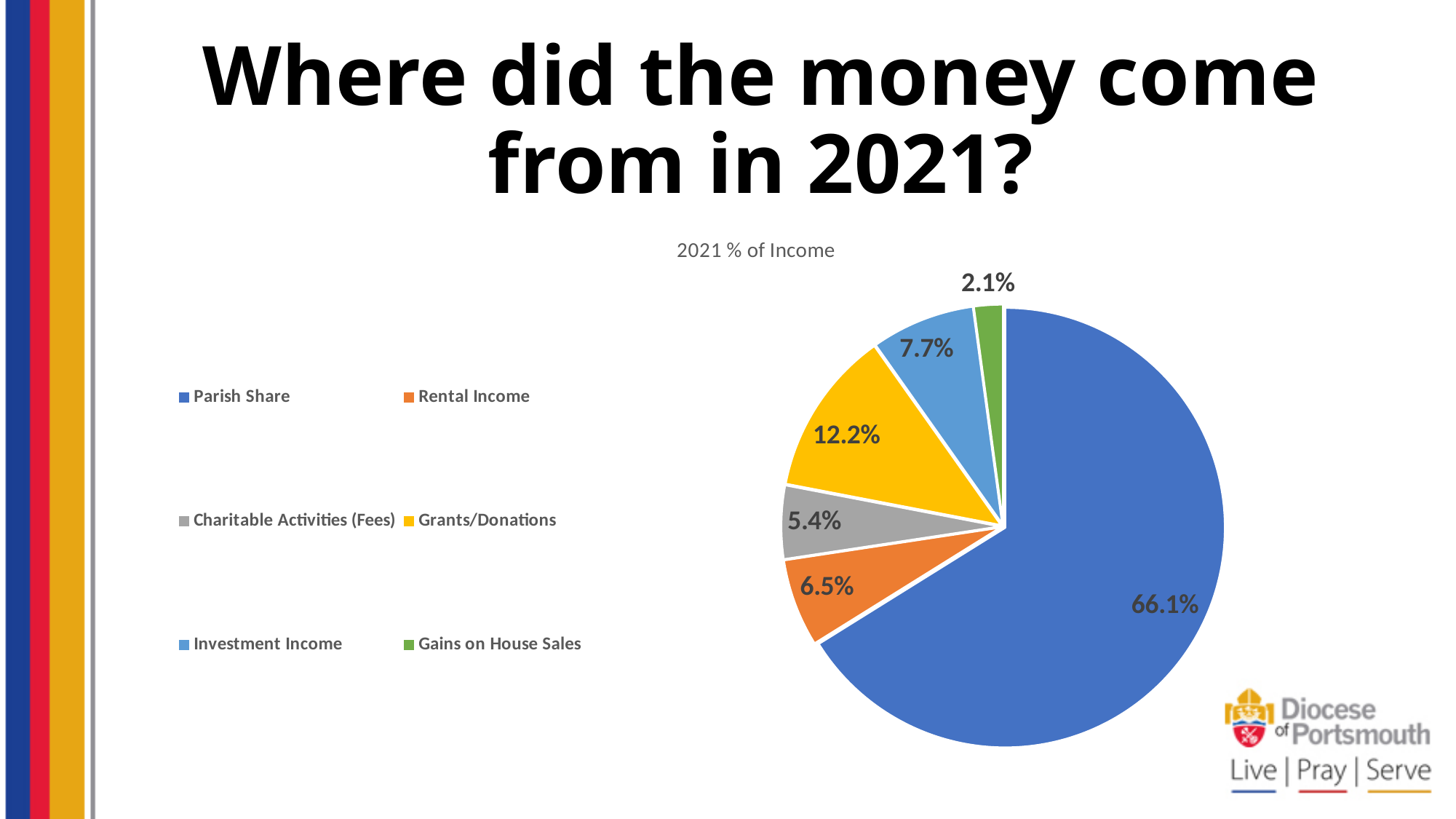
What share of 2021 income came from Gains on House Sales? 2.1% What share of 2021 income came from Investment Income? 7.7% What share of 2021 income came from Grants/Donations? 12.2% What share of 2021 income came from Charitable Activities (Fees)? 5.4% Which income source has the largest share of the pie? Parish Share What type of chart is shown on the slide? Pie chart What is the difference in percentage points between Grants/Donations and Investment Income? 4.5 What share of 2021 income came from Rental Income? 6.5% What share of 2021 income came from Parish Share? 66.1% Which income source has the smallest share of the pie? Gains on House Sales Which is larger, the share for Rental Income or the share for Charitable Activities (Fees)? Rental Income How many income categories are shown in the pie chart? 6